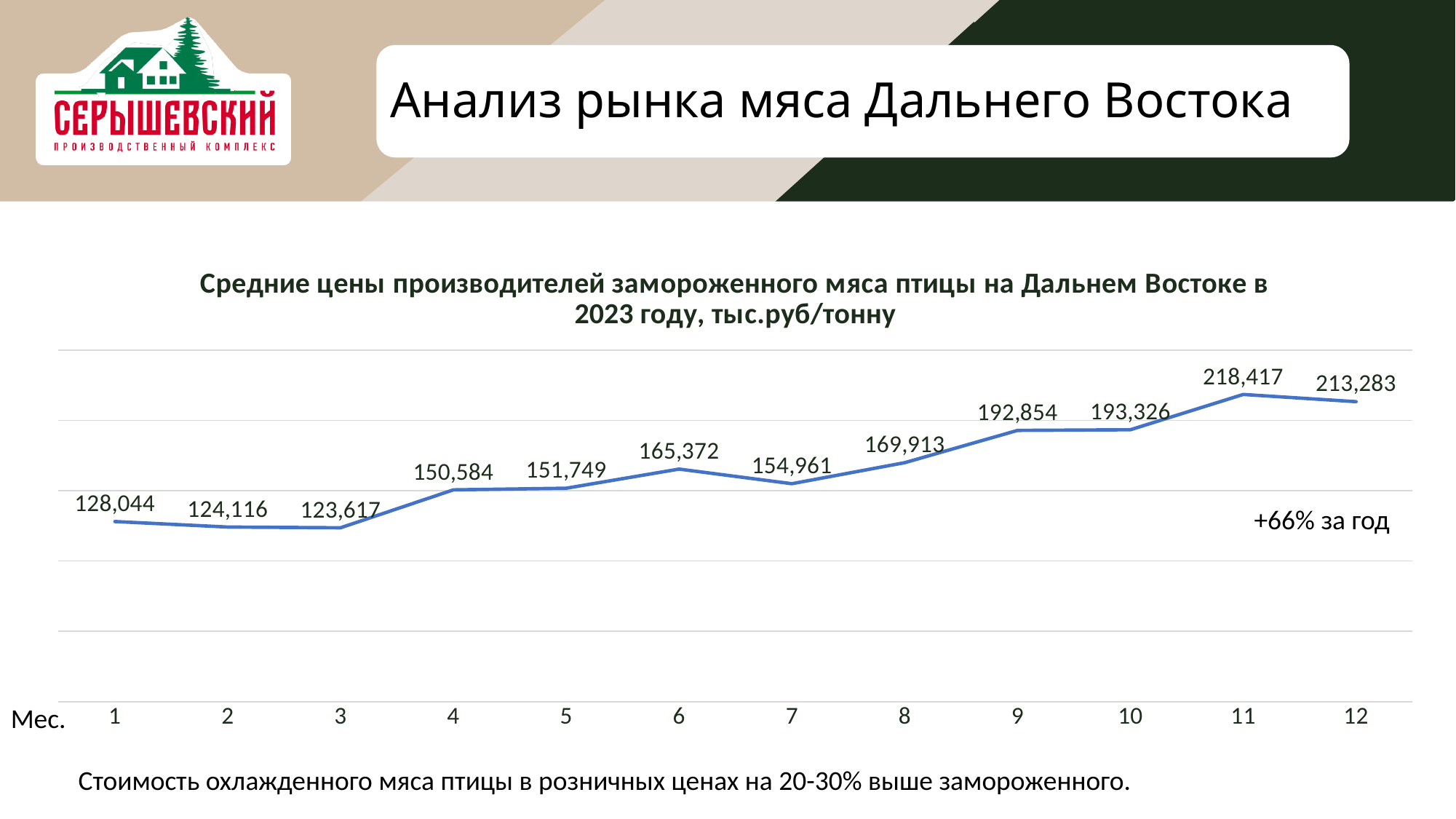
What is the average producer price of frozen poultry meat in month 1? 128,044 Which is larger, the value for month 9 or the value for month 10? Month 10 What is the difference between the value for month 12 and the value for month 1? 85,239 What type of chart is shown on the slide? Line chart How many months (data points) are plotted on the chart? 12 What annual change is annotated on the chart? +66% за год Do the values generally rise or fall from month 1 to month 12? Rise What is the difference between the value for month 11 and the value for month 1? 90,373 Which month has the lowest value on the chart? 3 Which month has the highest value on the chart? 11 What is the value plotted for month 7? 154,961 What is the value plotted for month 12? 213,283